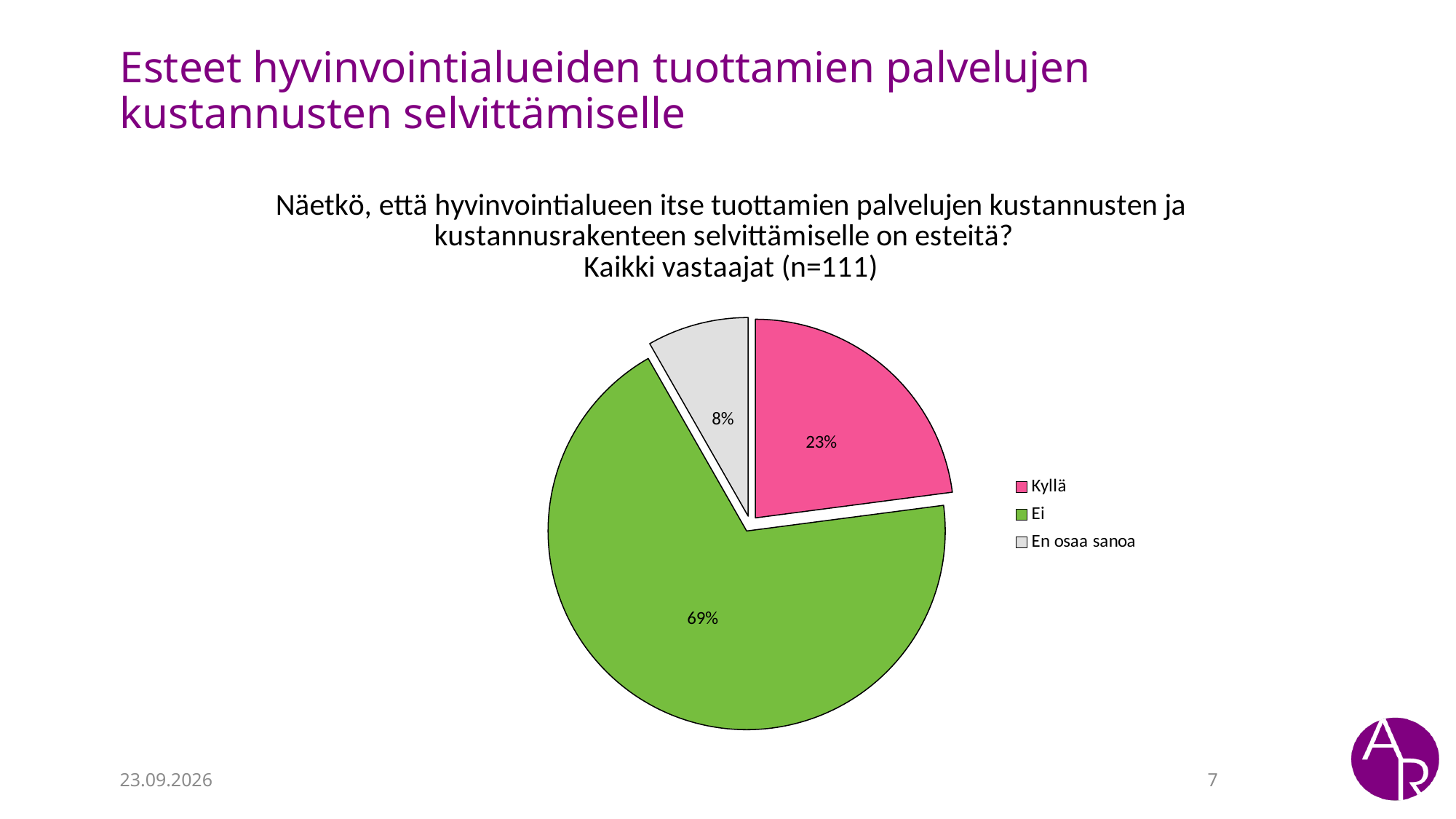
How many slices does the pie chart have? 3 Which slice is larger, "Kyllä" or "En osaa sanoa"? Kyllä What percentage of respondents answered "Ei"? 69% What percentage of respondents answered "Kyllä"? 23% What kind of chart is shown on the slide? Pie chart How many respondents (n) does the chart subtitle state? 111 What colour is the "Ei" slice? Green What is the difference in percentage points between the "Ei" and "Kyllä" slices? 46 What percentage of respondents answered "En osaa sanoa"? 8% Which response has the smallest share of the pie? En osaa sanoa How many entries does the legend list? 3 Which response has the largest share of the pie? Ei